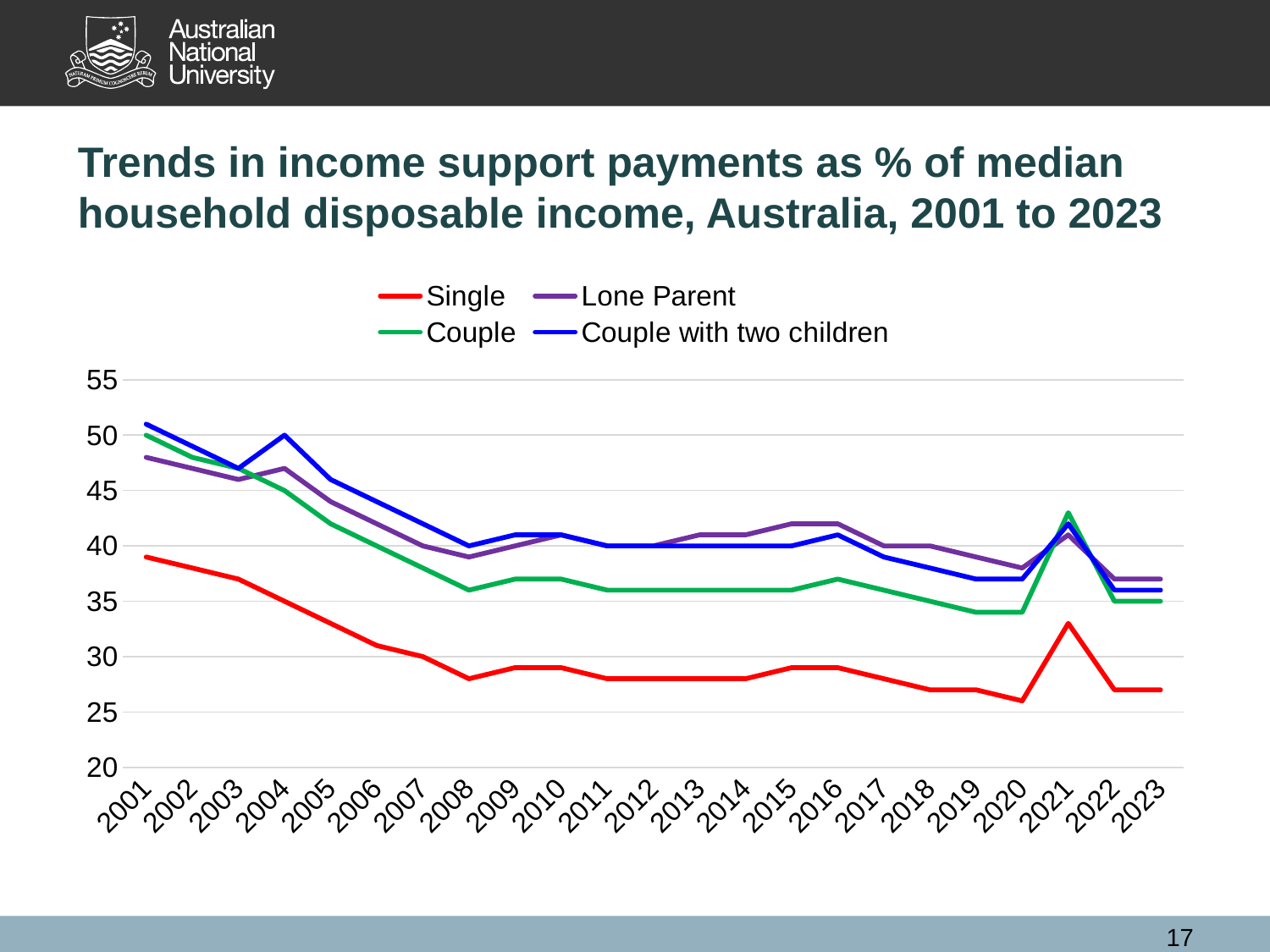
Is the value for Single in 2020 greater or less than 30? less Which series has the lowest values across the whole period? Single How many years are plotted along the x axis? 23 Is the value for Lone Parent in 2001 greater or less than 45? greater What colour is the line for Couple with two children? blue What kind of chart is shown on the slide? line chart Is the value for Couple in 2021 greater or less than 40? greater How many series does the legend list? 4 Does the Single series rise or fall overall from 2001 to 2023? fall Which is larger for the Single series: the value in 2020 or the value in 2021? 2021